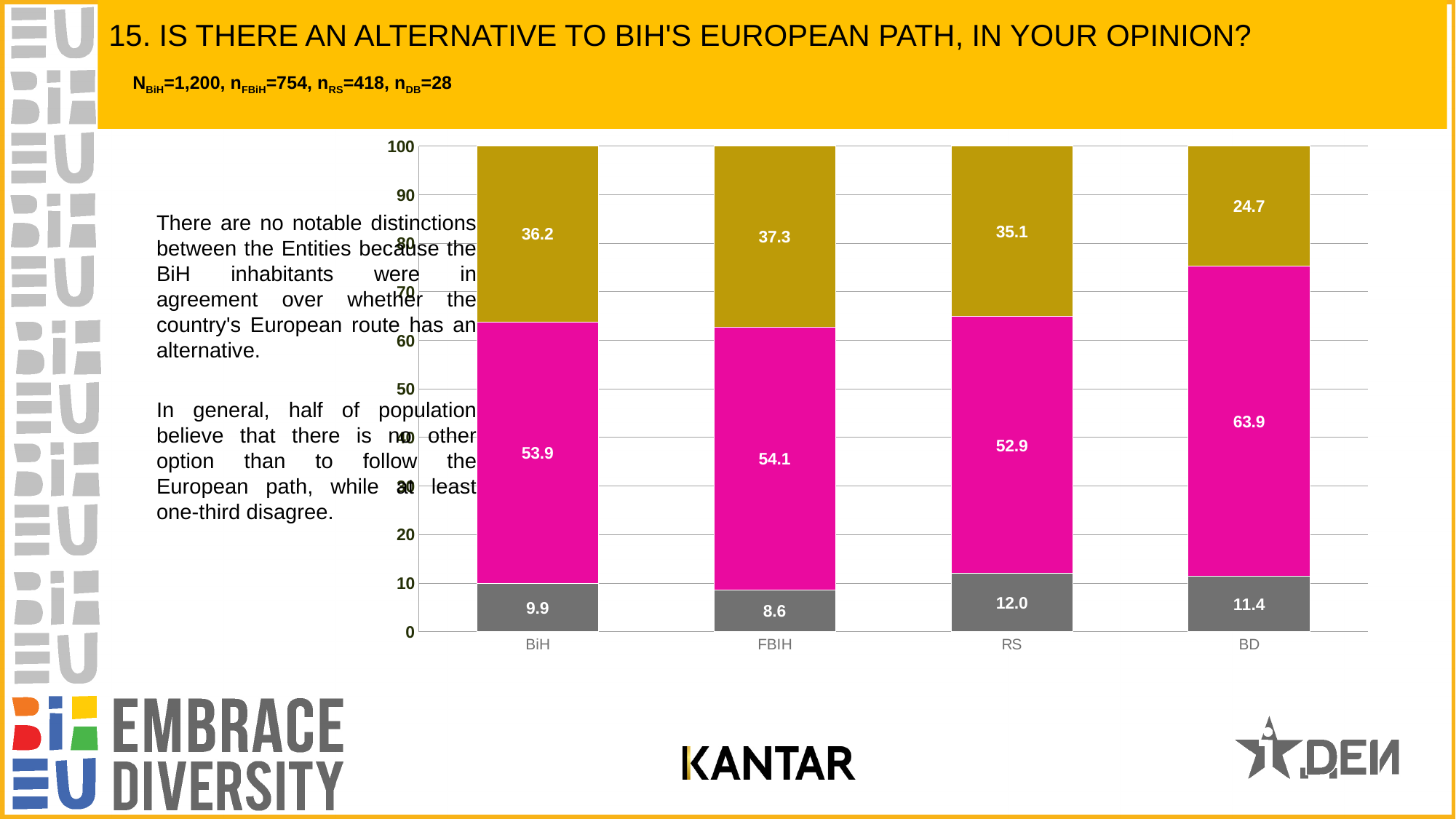
What is the difference between the magenta (middle) segment for BD and the magenta segment for RS? 11.0 What is the difference between the gold (top) segment for BiH and the gold segment for BD? 11.5 Which category has the smallest grey (bottom) segment? FBIH Which category has the smallest gold (top) segment? BD What is the total of the stacked bar for BiH? 100.0 What is the value of the magenta (middle) segment for BD? 63.9 What kind of chart is shown on the slide? Stacked bar chart How many categories are shown on the x axis? 4 Which category has the largest magenta (middle) segment? BD Which is larger, the grey (bottom) segment for RS or the grey segment for BD? RS What is the value of the gold (top) segment for FBIH? 37.3 What is the value of the grey (bottom) segment for RS? 12.0